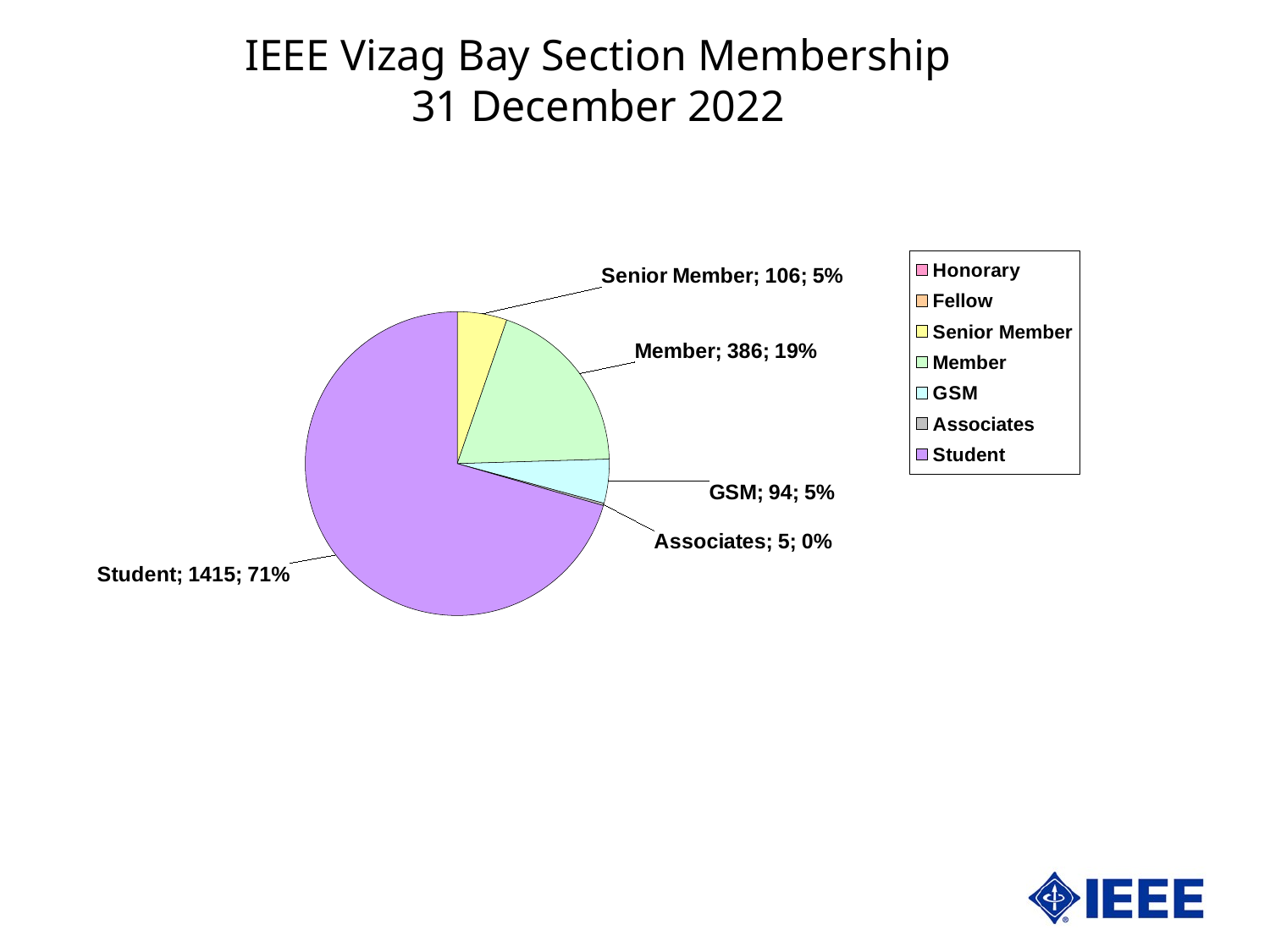
How many members are in the Member category? 386 What share of the pie does the Student slice represent? 71% What kind of chart is shown on the slide? pie chart What is the difference between the Member count and the Senior Member count? 280 What share of the pie does the Member slice represent? 19% Which is larger, the Senior Member count or the GSM count? Senior Member How many members are in the Student category? 1415 How many members are in the GSM category? 94 Which labelled category has the smallest slice of the pie? Associates How many entries does the legend list? 7 How many members are in the Senior Member category? 106 Which category has the largest slice of the pie? Student